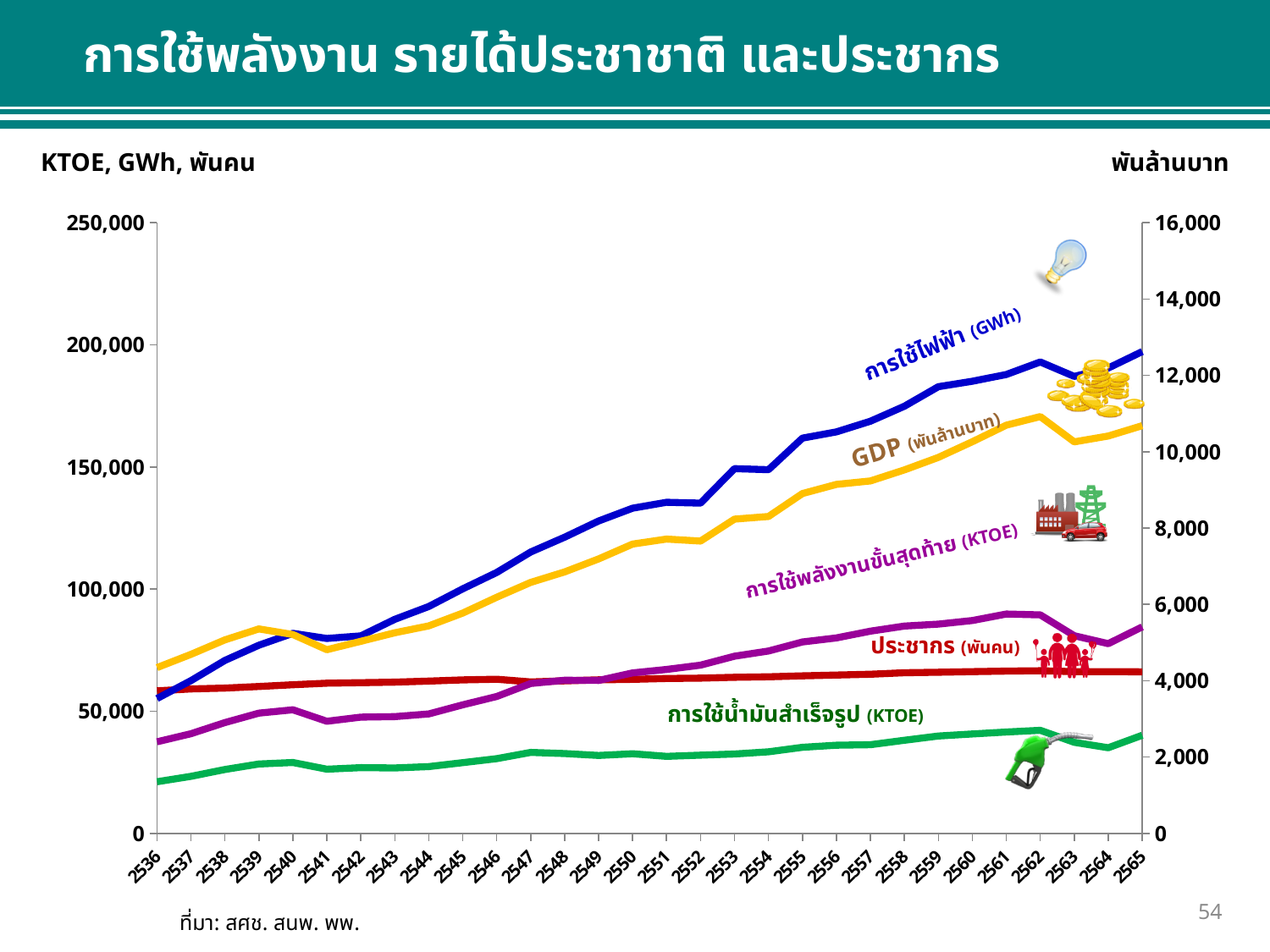
Which series has the highest value in 2565? การใช้ไฟฟ้า (GWh) In 2565, which is higher: electricity use (การใช้ไฟฟ้า) or final energy consumption (การใช้พลังงานขั้นสุดท้าย)? การใช้ไฟฟ้า Does the GDP line rise or fall between 2562 and 2563? fall Is the value for electricity use (การใช้ไฟฟ้า) in 2565 greater or less than 150,000? greater Is the value for population (ประชากร) in 2565 greater or less than 100,000? less How many years are shown along the x axis of the chart? 30 Which series has the lowest values across the whole chart? การใช้น้ำมันสำเร็จรูป (KTOE) How many data series are plotted on the chart? 5 Is the value for finished oil use (การใช้น้ำมันสำเร็จรูป) in 2536 greater or less than 50,000? less What unit is shown on the right-hand axis of the chart? พันล้านบาท What kind of chart is shown on the slide? line chart Does the electricity use (การใช้ไฟฟ้า, GWh) line generally rise or fall from 2536 to 2565? rise